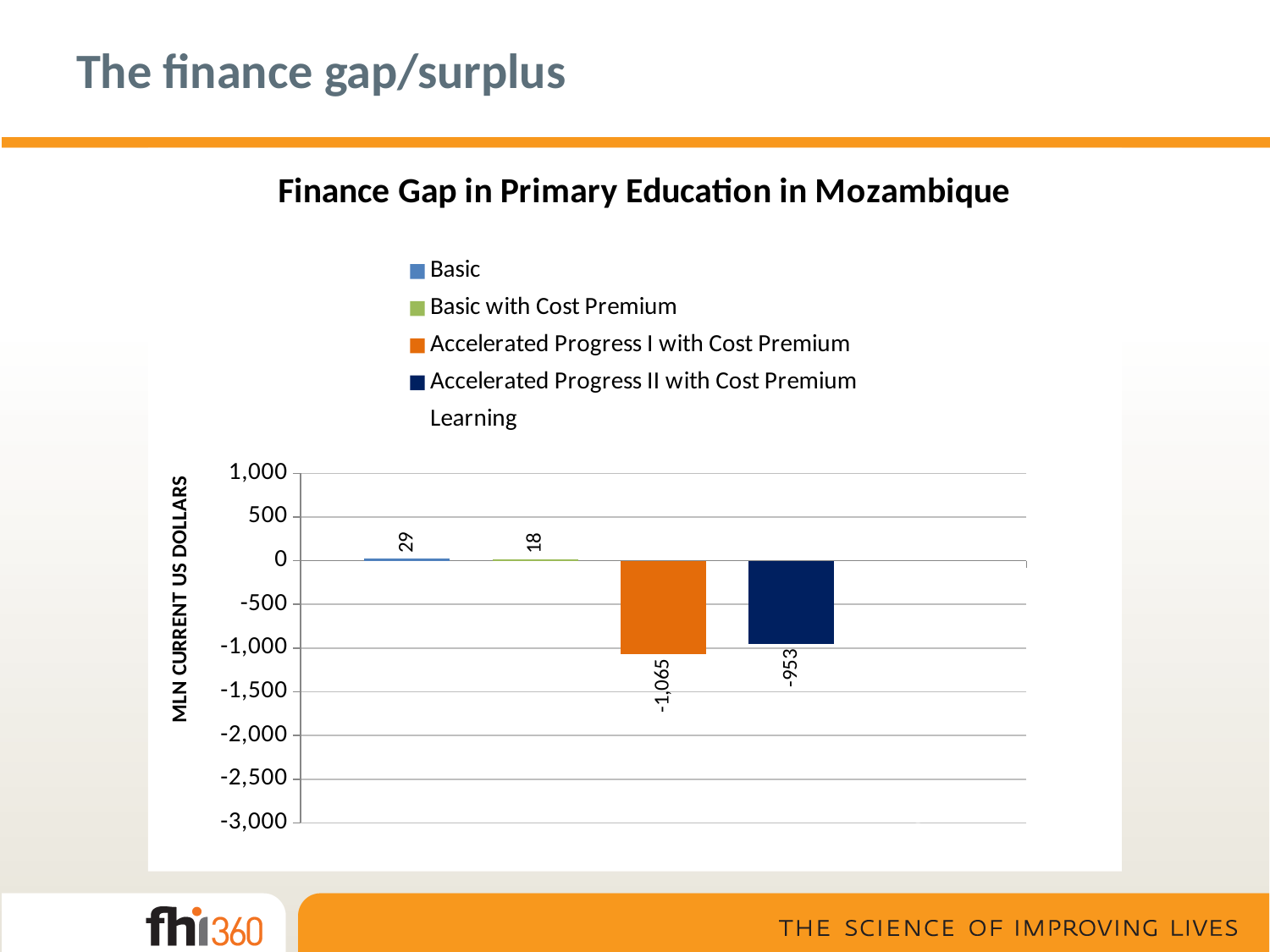
Which series has the lowest value? Accelerated Progress I with Cost Premium What is the title of the vertical axis? MLN CURRENT US DOLLARS What is the value for Basic in the Finance Gap in Primary Education in Mozambique chart? 29 What is the value for Accelerated Progress I with Cost Premium? -1,065 Which series has the highest value? Basic Is the value for Accelerated Progress I with Cost Premium greater or less than -1,000? less What is the difference between the values for Basic and Basic with Cost Premium? 11 What is the value for Basic with Cost Premium? 18